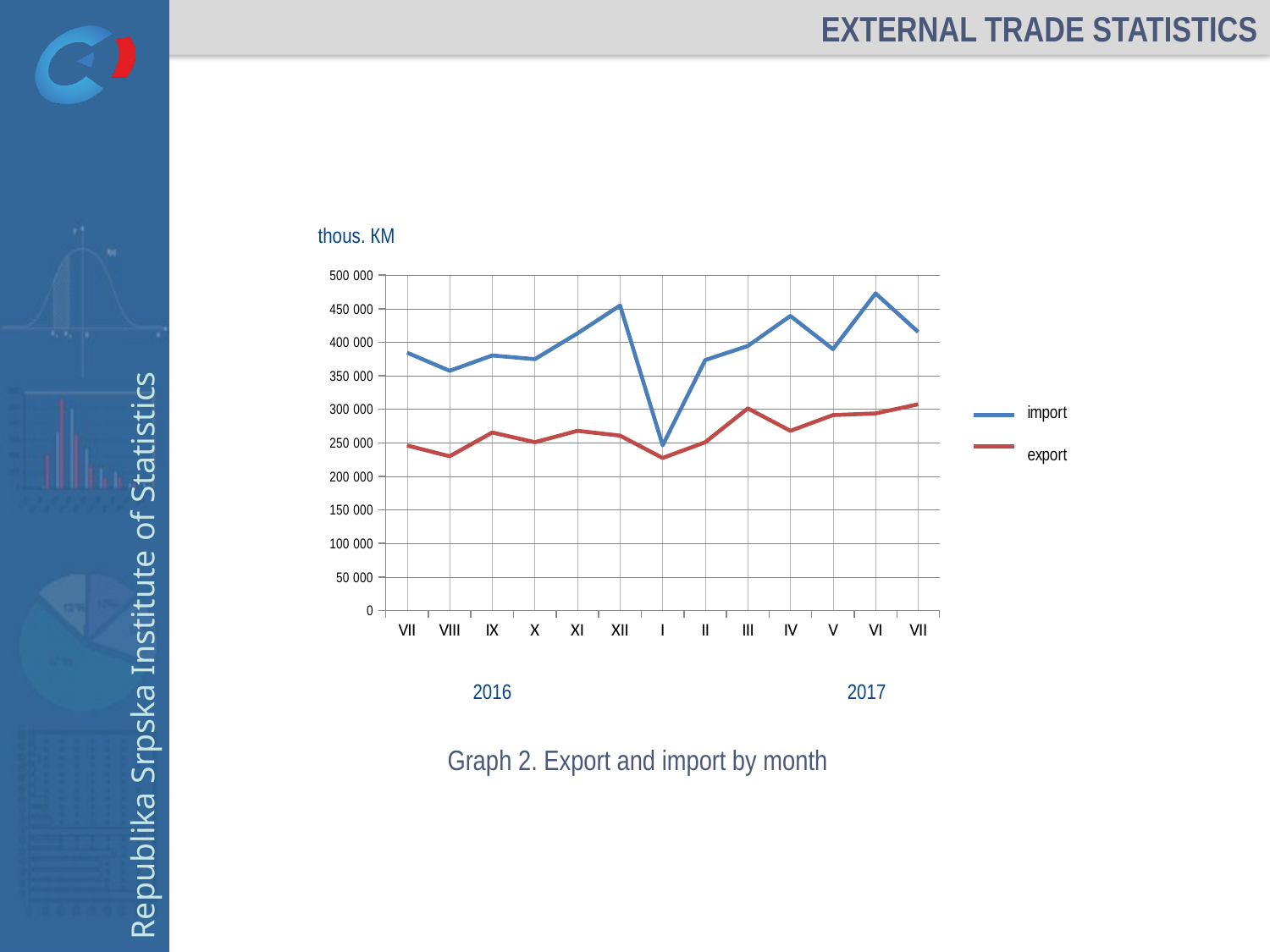
In which month is the import line at its lowest? I (2017) Does the import line rise or fall from month I of 2017 to month VI of 2017? rise In month XII of 2016, which is larger, import or export? import Is the import value for month VI of 2017 greater or less than 450 000? greater How many series does the legend list? 2 How many monthly points are plotted along the x axis? 13 Is the export value for month III of 2017 greater or less than 250 000? greater Is the export value for month VIII of 2016 greater or less than 250 000? less What kind of chart is shown on the slide? line chart What unit is stated above the chart? thous. KM In which month is the import line at its highest? VI (2017)